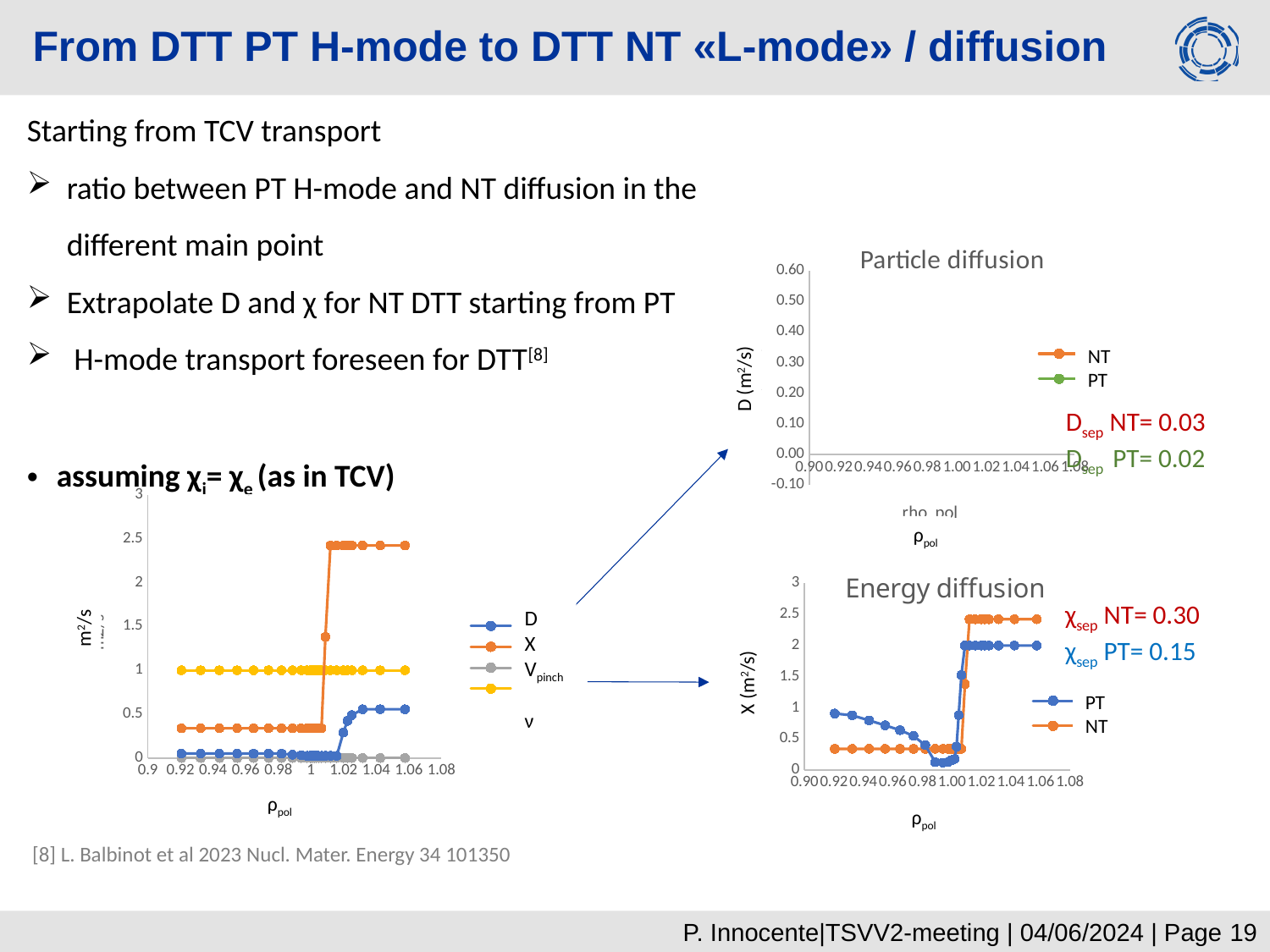
In the Energy diffusion chart, which series has the higher value at ρpol = 1.04, PT or NT? NT What is the title of the top-right chart? Particle diffusion How many series does the legend of the Energy diffusion chart list? 2 What value of χsep for NT is printed next to the Energy diffusion chart? 0.30 How many series does the legend of the bottom-left chart list? 4 In the Energy diffusion chart, is the PT value at ρpol = 0.92 greater or less than 0.5? greater In the Energy diffusion chart, is the NT value at ρpol = 0.92 greater or less than 0.5? less In the Energy diffusion chart, which series has the higher value at ρpol = 0.92, PT or NT? PT In the Energy diffusion chart, does the PT series rise or fall between ρpol = 0.92 and ρpol = 0.98? fall What kind of chart is the Energy diffusion chart? line chart In the bottom-left chart, is the X series value at ρpol = 1.04 greater or less than 2? greater